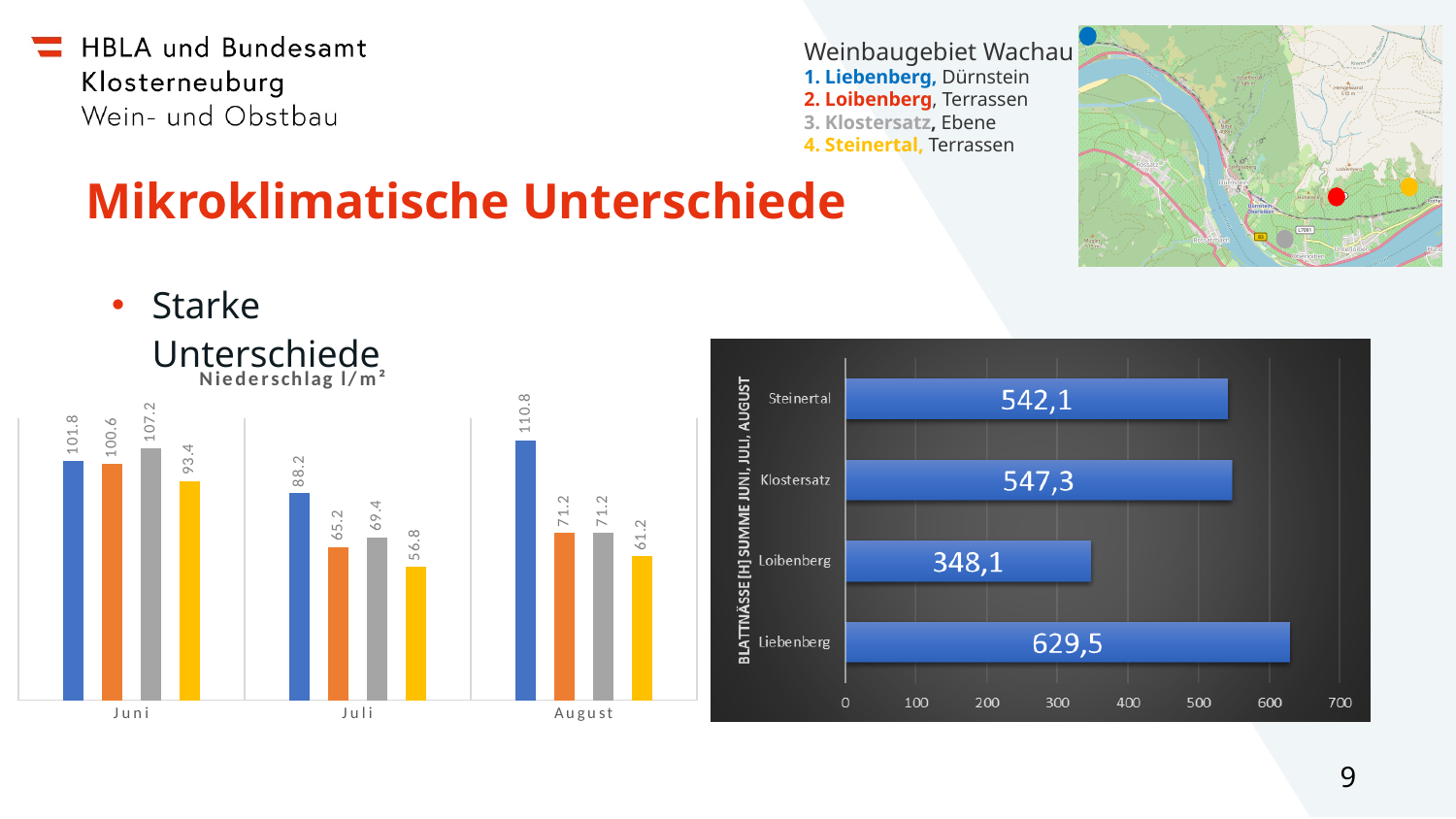
In the Blattnässe chart on the right, how many categories are shown? 4 In the Niederschlag l/m² chart on the left, which month has the highest value for the gray bar? Juni In the Niederschlag l/m² chart on the left, what is the value of the blue bar for August? 110.8 In the Niederschlag l/m² chart on the left, what is the difference between the blue bar and the orange bar for Juli? 23.0 In the Blattnässe chart on the right, which category has the lowest value? Loibenberg In the Niederschlag l/m² chart on the left, how many months are shown on the x axis? 3 In the Niederschlag l/m² chart on the left, what is the value of the yellow bar for Juli? 56.8 What kind of chart is the Blattnässe chart on the right? Bar chart In the Blattnässe chart on the right, what is the difference between Klostersatz and Steinertal? 5,2 In the Blattnässe chart on the right, what is the value for Loibenberg? 348,1 In the Blattnässe chart on the right, which category has the highest value? Liebenberg In the Blattnässe chart on the right, what is the value for Liebenberg? 629,5